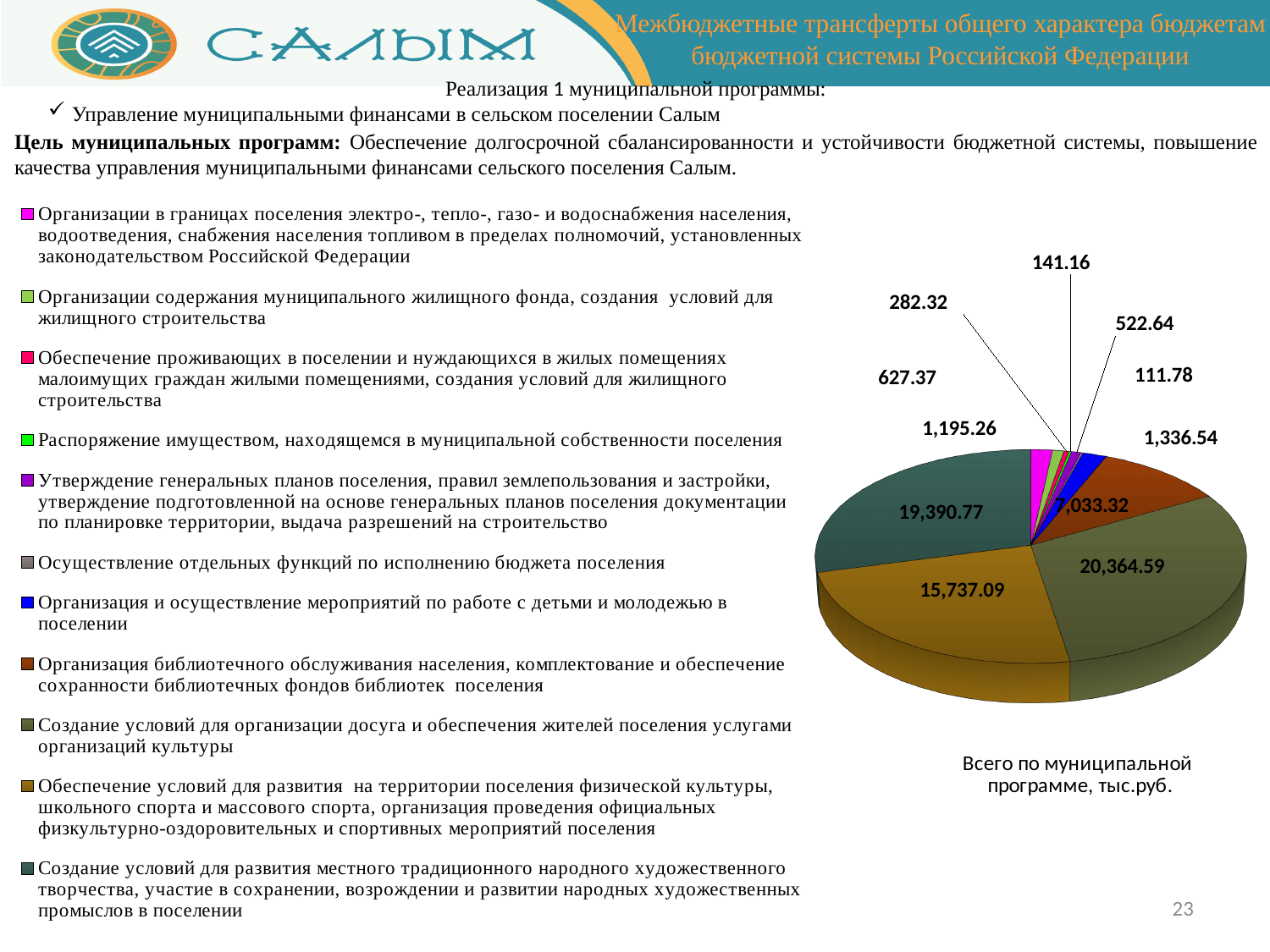
What is the smallest value shown on the pie chart? 111.78 What is the difference between the two largest values on the pie chart, 20,364.59 and 19,390.77? 973.82 What kind of chart is shown on the slide? pie chart What is the total of all values shown on the pie chart? 66,742.84 What is the difference between the values 15,737.09 and 7,033.32 on the pie chart? 8,703.77 What is the largest value shown on the pie chart? 20,364.59 How many slices does the pie chart have? 11 Which is larger on the pie chart: the slice labelled 1,336.54 or the slice labelled 1,195.26? 1,336.54 Which is larger on the pie chart: the slice labelled 627.37 or the slice labelled 282.32? 627.37 How many entries does the legend of the pie chart list? 11 In what units are the values on the pie chart given, according to the caption? тыс.руб. What caption is written below the pie chart? Всего по муниципальной программе, тыс.руб.